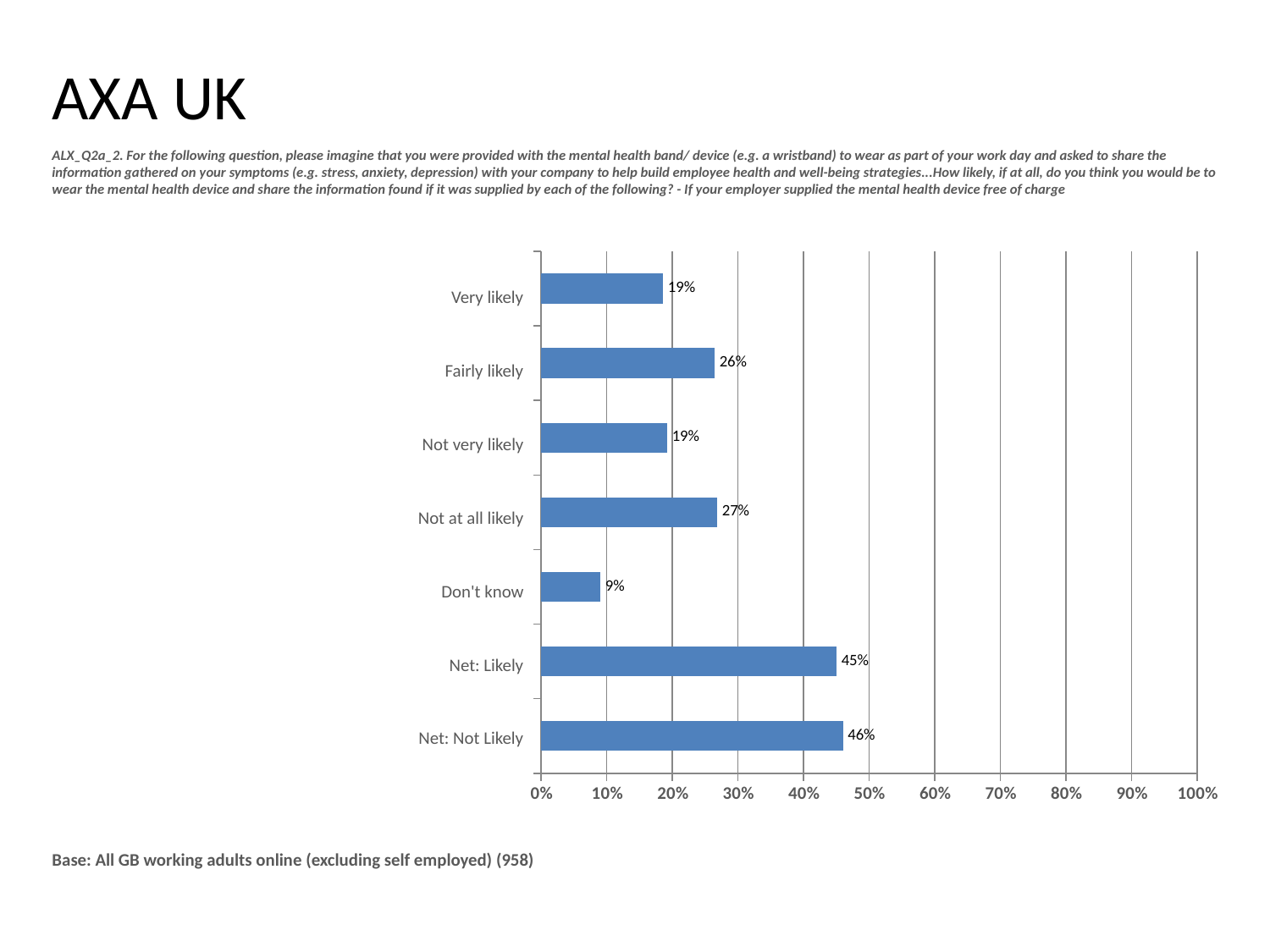
What is the difference between Net: Not Likely and Net: Likely? 1% How many categories are shown on the chart? 7 Which category has the lowest value? Don't know What is the value for Don't know? 9% What kind of chart is shown on the slide? Bar chart Which is larger, Fairly likely or Not very likely? Fairly likely What is the value for Very likely? 19% Is the value for Net: Likely greater or less than 40%? greater What is the value for Fairly likely? 26% What is the value for Net: Not Likely? 46% Which category has the highest value? Net: Not Likely What is the difference between Not at all likely and Very likely? 8%